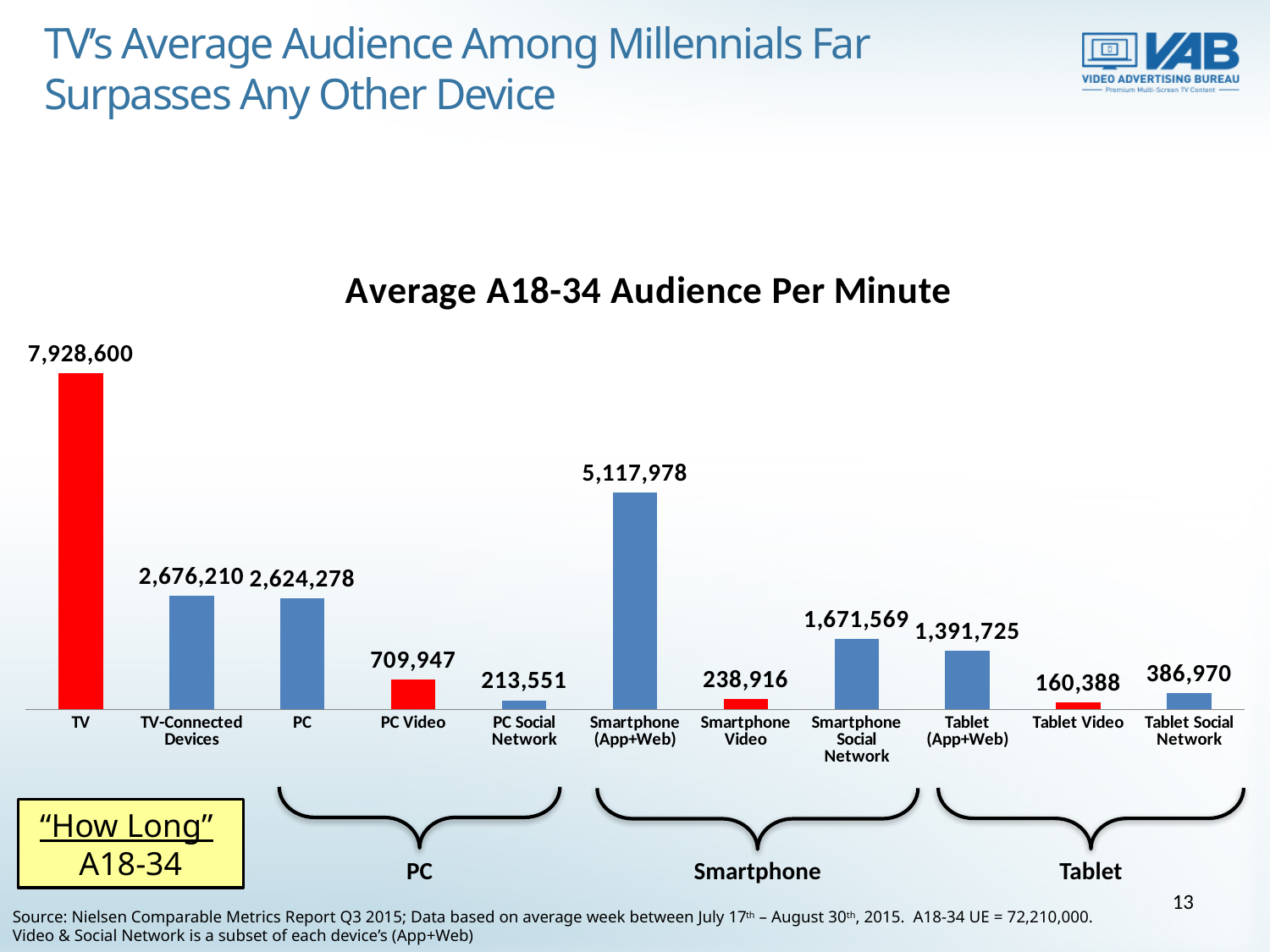
Which category has the highest Average A18-34 Audience Per Minute? TV What is the difference between the Tablet Social Network value and the Tablet Video value? 226,582 What is the value shown for Smartphone (App+Web)? 5,117,978 Which is larger, the value for Smartphone Social Network or the value for Tablet (App+Web)? Smartphone Social Network Which category has the lowest Average A18-34 Audience Per Minute? Tablet Video What is the title of the chart? Average A18-34 Audience Per Minute How many categories are plotted in the chart? 11 What is the Average A18-34 Audience Per Minute for TV? 7,928,600 What is the value shown for PC Social Network? 213,551 What kind of chart is shown on the slide? Bar chart What is the value shown for Tablet Video? 160,388 What is the difference between the TV value and the Smartphone (App+Web) value? 2,810,622